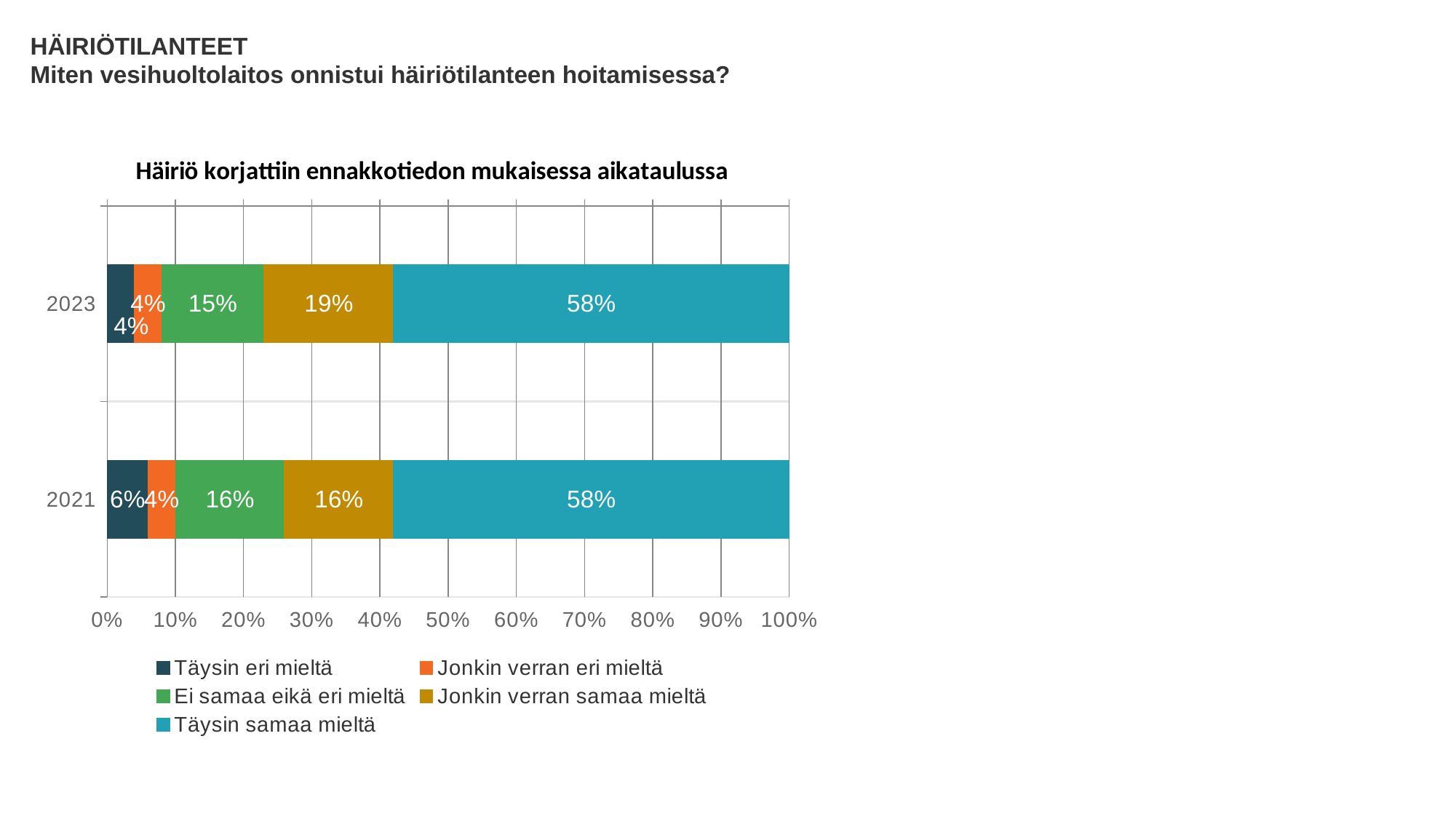
What is the value for "Täysin eri mieltä" in 2021? 6% Which series has the largest share in the 2023 bar? Täysin samaa mieltä What is the difference between the "Jonkin verran samaa mieltä" values for 2023 and 2021? 3% How many series does the legend list? 5 What is the total of the stacked bar for 2021? 100% What is the value for "Ei samaa eikä eri mieltä" in 2021? 16% How many years (categories) are shown on the chart? 2 What is the value for "Täysin samaa mieltä" in 2023? 58% What is the title of the chart? Häiriö korjattiin ennakkotiedon mukaisessa aikataulussa Which year has the larger value for "Täysin eri mieltä", 2023 or 2021? 2021 What is the value for "Jonkin verran samaa mieltä" in 2023? 19% What kind of chart is shown on the slide? Stacked bar chart